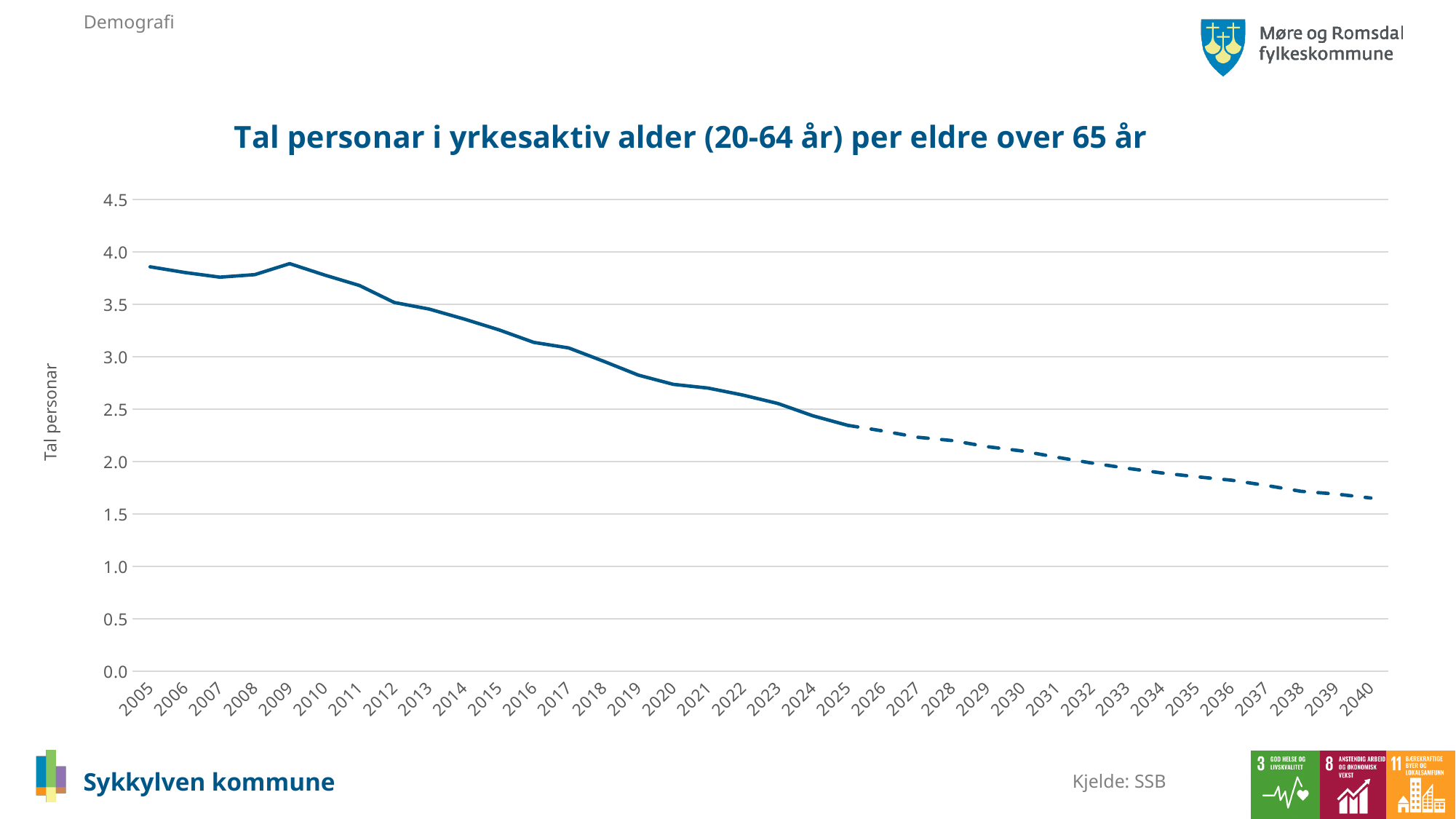
Which is larger, the value for 2015 or the value for 2025? 2015 Which is larger, the value for 2005 or the value for 2040? 2005 Do the values generally rise or fall from 2009 to 2040? fall Which year has the lowest value on the chart? 2040 Is the value for 2020 greater or less than 3.0? less How many years are shown on the x axis of the chart? 36 What is the label on the y axis of the chart? Tal personar Is the value for 2015 greater or less than 3.0? greater Is the value for 2040 greater or less than 2.0? less What kind of chart is shown on the slide? line chart What is the title of the chart? Tal personar i yrkesaktiv alder (20-64 år) per eldre over 65 år